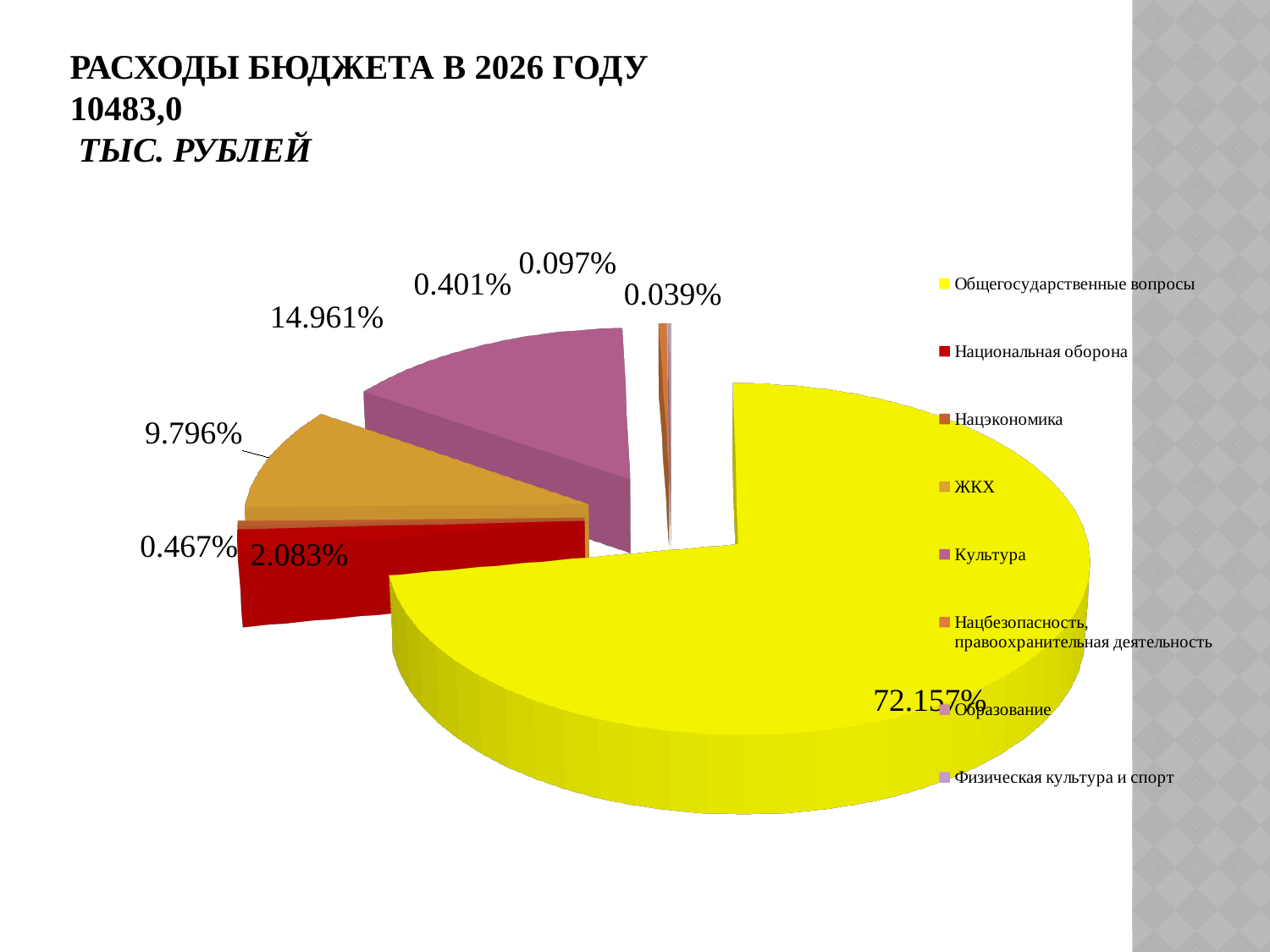
Which has the larger share, Культура or ЖКХ? Культура What is the difference in percentage points between Культура and ЖКХ? 5.165% What is the smallest percentage label shown on the pie chart? 0.039% What percentage is shown for ЖКХ? 9.796% What share of the pie is labelled for Общегосударственные вопросы? 72.157% How many categories does the legend of the pie chart list? 8 Which category has the largest share of the pie? Общегосударственные вопросы What percentage is shown for Культура? 14.961% What percentage is shown for Национальная оборона? 2.083% What is the difference in percentage points between Общегосударственные вопросы and Культура? 57.196% What type of chart is shown on the slide? pie chart What colour is the slice for Общегосударственные вопросы? yellow